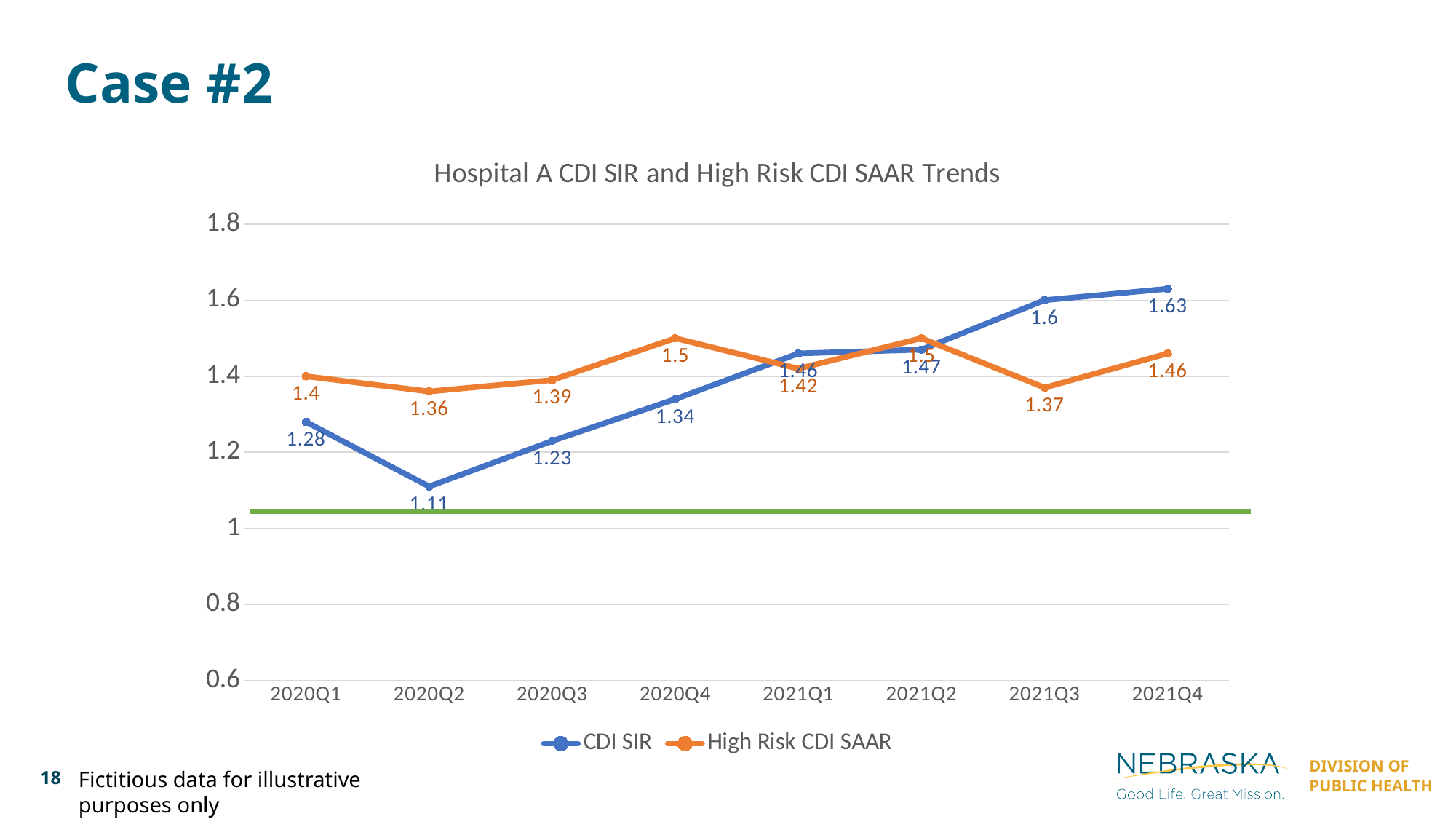
How many series does the legend list? 2 In which quarter is the CDI SIR lowest? 2020Q2 How many quarters are shown on the x axis? 8 What is the difference between the CDI SIR values for 2021Q4 and 2020Q2? 0.52 In which quarter is the CDI SIR highest? 2021Q4 Which is larger in 2020Q4, the CDI SIR or the High Risk CDI SAAR? High Risk CDI SAAR What is the CDI SIR value for 2020Q2? 1.11 What is the High Risk CDI SAAR value for 2021Q3? 1.37 What is the title of the chart? Hospital A CDI SIR and High Risk CDI SAAR Trends In which quarter is the High Risk CDI SAAR lowest? 2020Q2 What is the CDI SIR value for 2021Q4? 1.63 What kind of chart is shown on the slide? Line chart